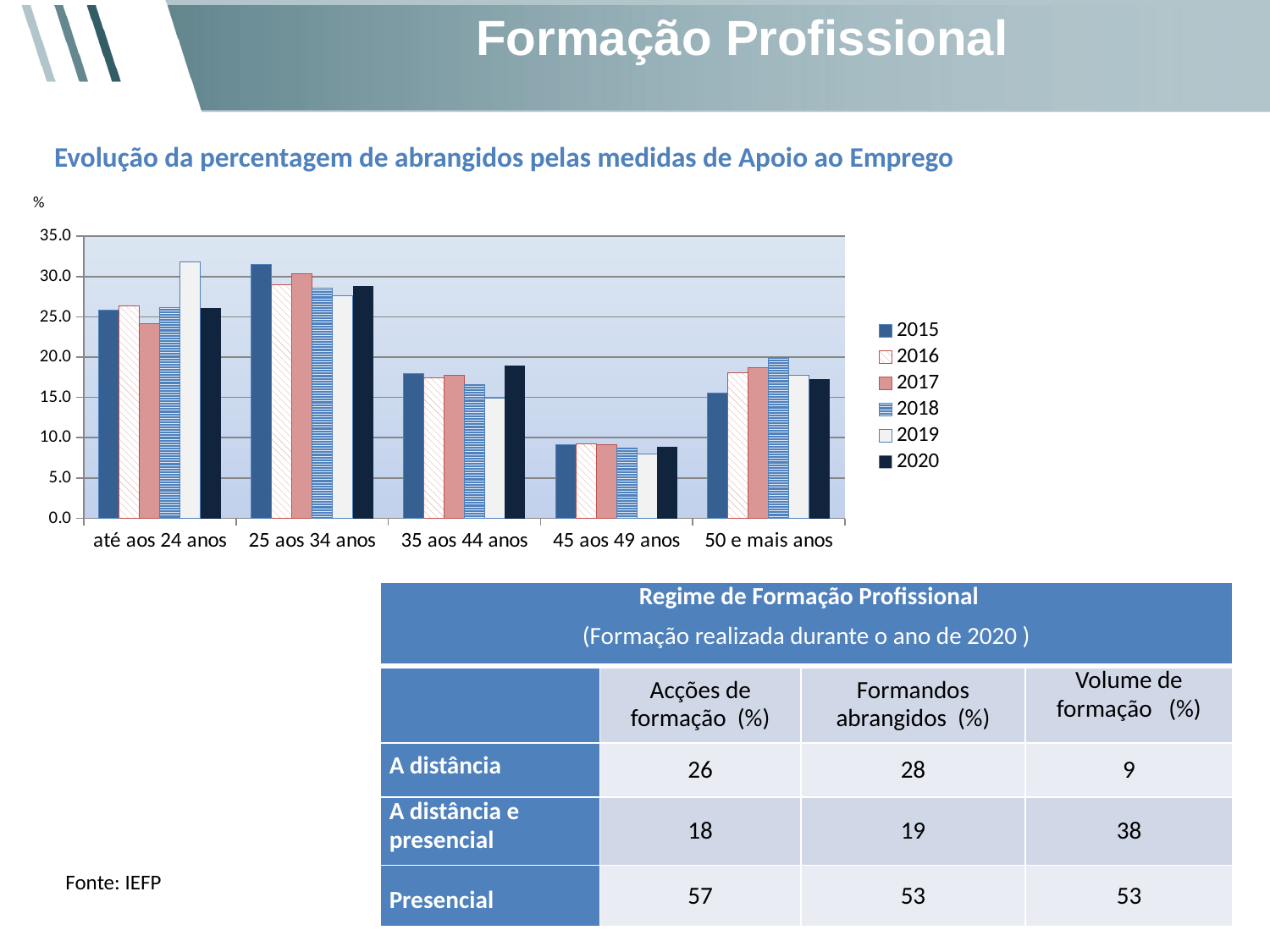
How many series does the chart's legend list? 6 What unit is indicated on the chart's vertical axis? % Is the 2015 value for '25 aos 34 anos' greater or less than 30? greater How many age-group categories are shown on the x axis of the chart? 5 In the 'até aos 24 anos' group, which is larger: the 2019 value or the 2017 value? 2019 What kind of chart is shown on the slide? bar chart Is the 2019 value for 'até aos 24 anos' greater or less than 30? greater Is the 2015 value for '50 e mais anos' greater or less than 20? less For the 2020 series, which age group has the highest value? 25 aos 34 anos Which age group has the lowest values across all years in the chart? 45 aos 49 anos In the '50 e mais anos' group, which year has the highest bar? 2018